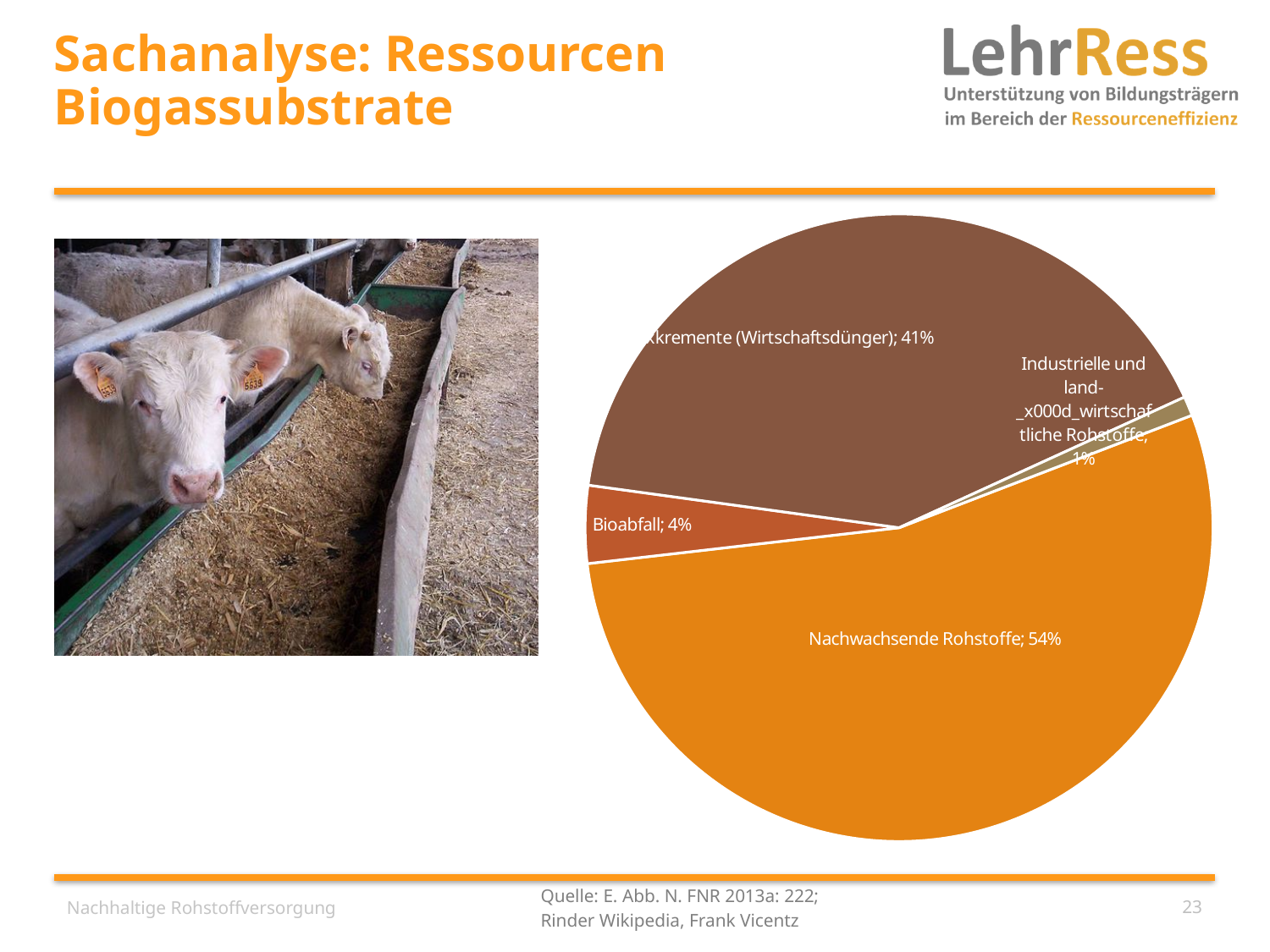
What share of the pie does the Wirtschaftsdünger (Exkremente) slice have? 41% What colour is the Nachwachsende Rohstoffe slice in the pie chart? orange What share of the pie does Industrielle und landwirtschaftliche Rohstoffe have? 1% Which is larger, the share for Bioabfall or the share for Industrielle und landwirtschaftliche Rohstoffe? Bioabfall What is the difference in percentage points between Nachwachsende Rohstoffe and the Wirtschaftsdünger (Exkremente) slice? 13 percentage points What share of the pie does Nachwachsende Rohstoffe have? 54% Which slice of the pie chart is the smallest? Industrielle und landwirtschaftliche Rohstoffe How many slices does the pie chart have? 4 Which slice of the pie chart is the largest? Nachwachsende Rohstoffe What kind of chart is shown on the slide? pie chart What is the difference in percentage points between Bioabfall and Industrielle und landwirtschaftliche Rohstoffe? 3 percentage points